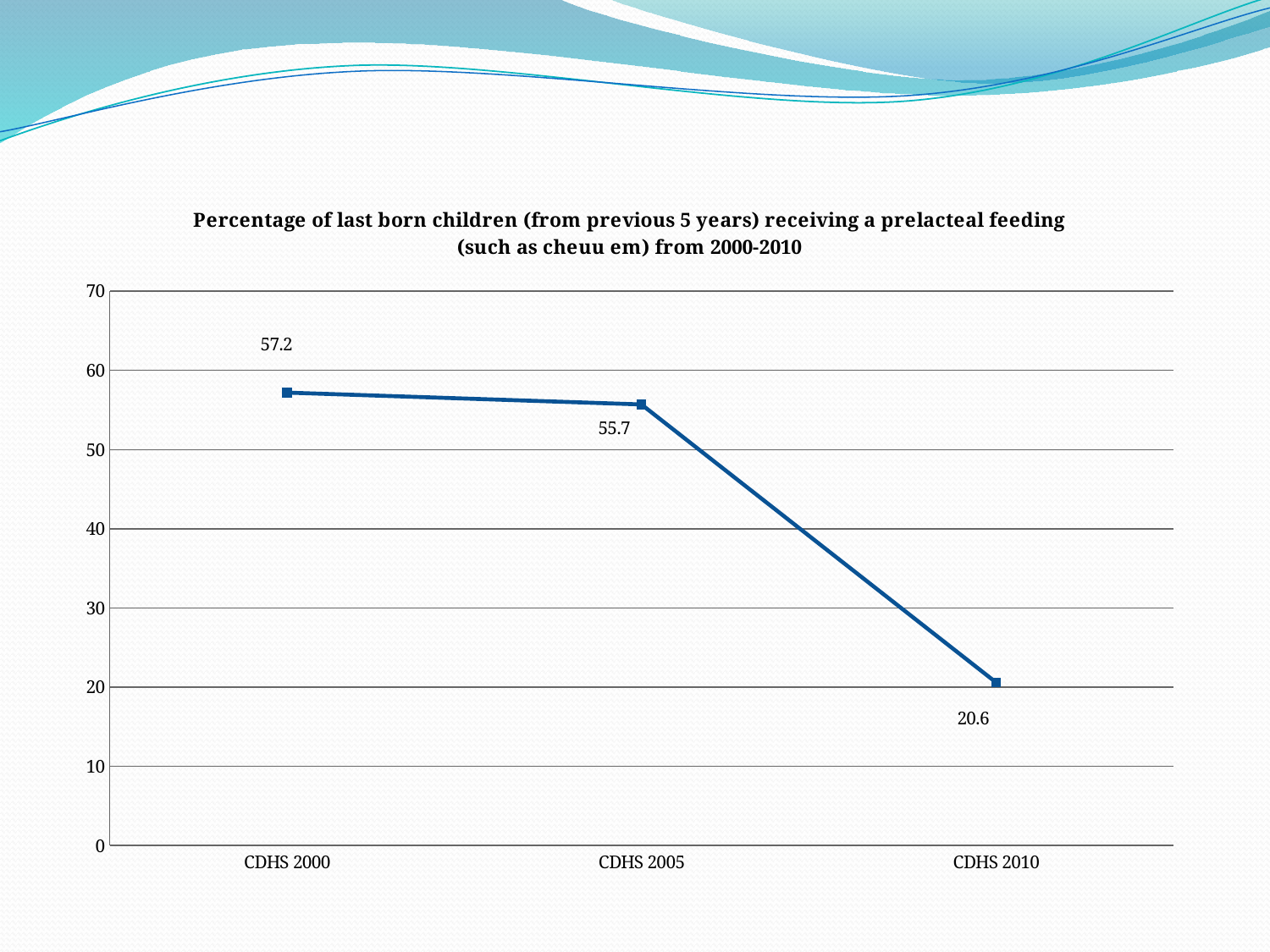
Is the value for CDHS 2010 greater or less than 30? less What is the difference between the values for CDHS 2005 and CDHS 2010? 35.1 Which survey has the lowest value? CDHS 2010 How many data points are plotted on the chart? 3 What kind of chart is shown on the slide? line chart What is the value for CDHS 2000? 57.2 What is the difference between the values for CDHS 2000 and CDHS 2005? 1.5 Which is larger, the value for CDHS 2005 or CDHS 2010? CDHS 2005 Do the values rise or fall from CDHS 2000 to CDHS 2010? fall Which survey has the highest value? CDHS 2000 What is the value for CDHS 2010? 20.6 What is the value for CDHS 2005? 55.7